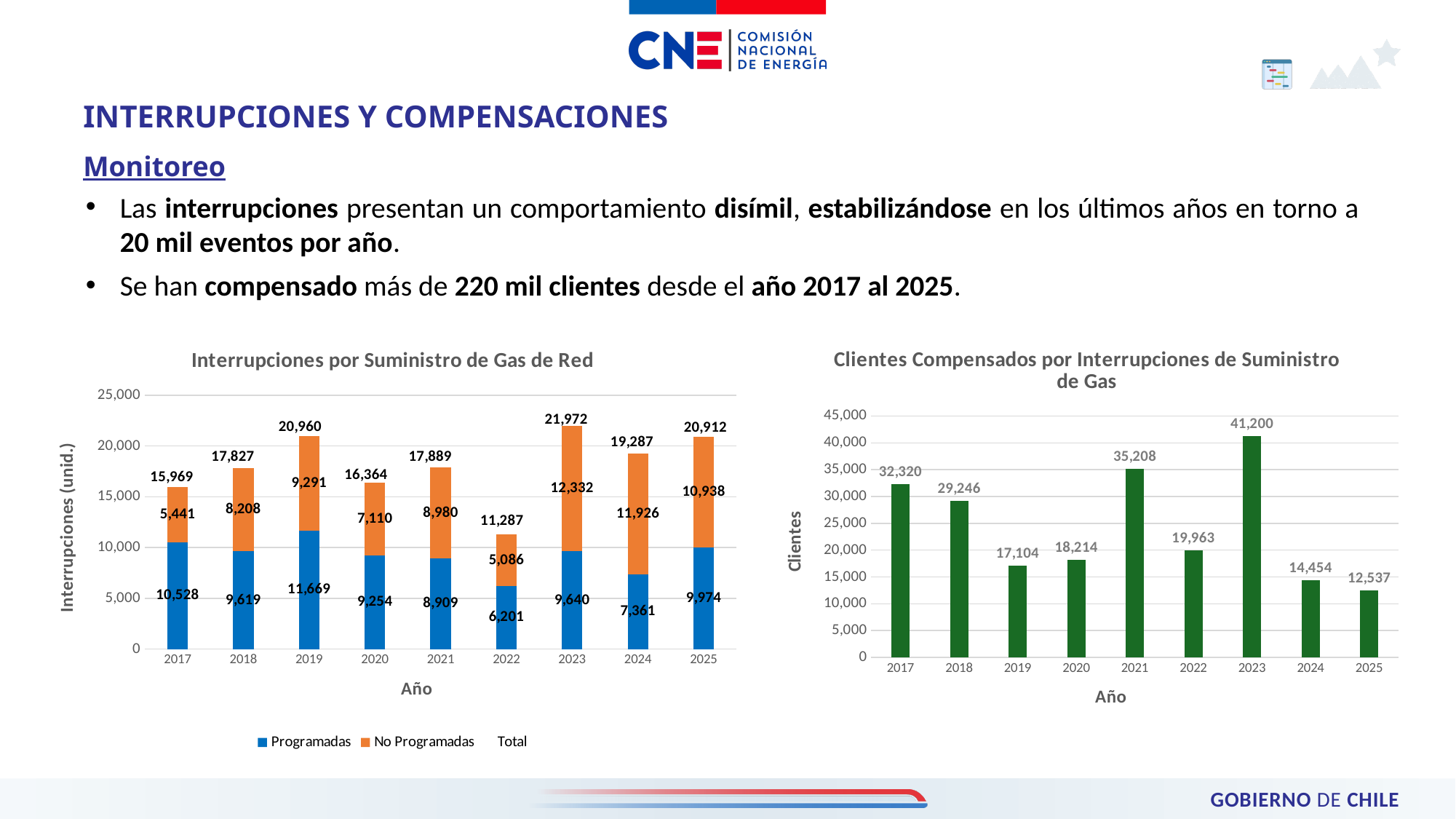
In the 'Interrupciones por Suministro de Gas de Red' chart, what is the No Programadas value for 2023? 12,332 In the 'Interrupciones por Suministro de Gas de Red' chart, which year has the highest total? 2023 In the 'Clientes Compensados por Interrupciones de Suministro de Gas' chart, what is the difference between 2023 and 2024? 26,746 In the 'Interrupciones por Suministro de Gas de Red' chart, what is the Programadas value for 2019? 11,669 In the 'Clientes Compensados por Interrupciones de Suministro de Gas' chart, which year has the lowest value? 2025 In the 'Interrupciones por Suministro de Gas de Red' chart, is the Programadas value for 2022 greater or less than the No Programadas value for 2022? greater What kind of chart is the 'Clientes Compensados por Interrupciones de Suministro de Gas' chart? Bar chart In the 'Interrupciones por Suministro de Gas de Red' chart, how many series does the legend list? 3 In the 'Clientes Compensados por Interrupciones de Suministro de Gas' chart, how many years are shown on the x axis? 9 In the 'Interrupciones por Suministro de Gas de Red' chart, what is the total for 2022? 11,287 In the 'Interrupciones por Suministro de Gas de Red' chart, what is the difference between the No Programadas and Programadas values in 2025? 964 In the 'Clientes Compensados por Interrupciones de Suministro de Gas' chart, what is the value for 2021? 35,208